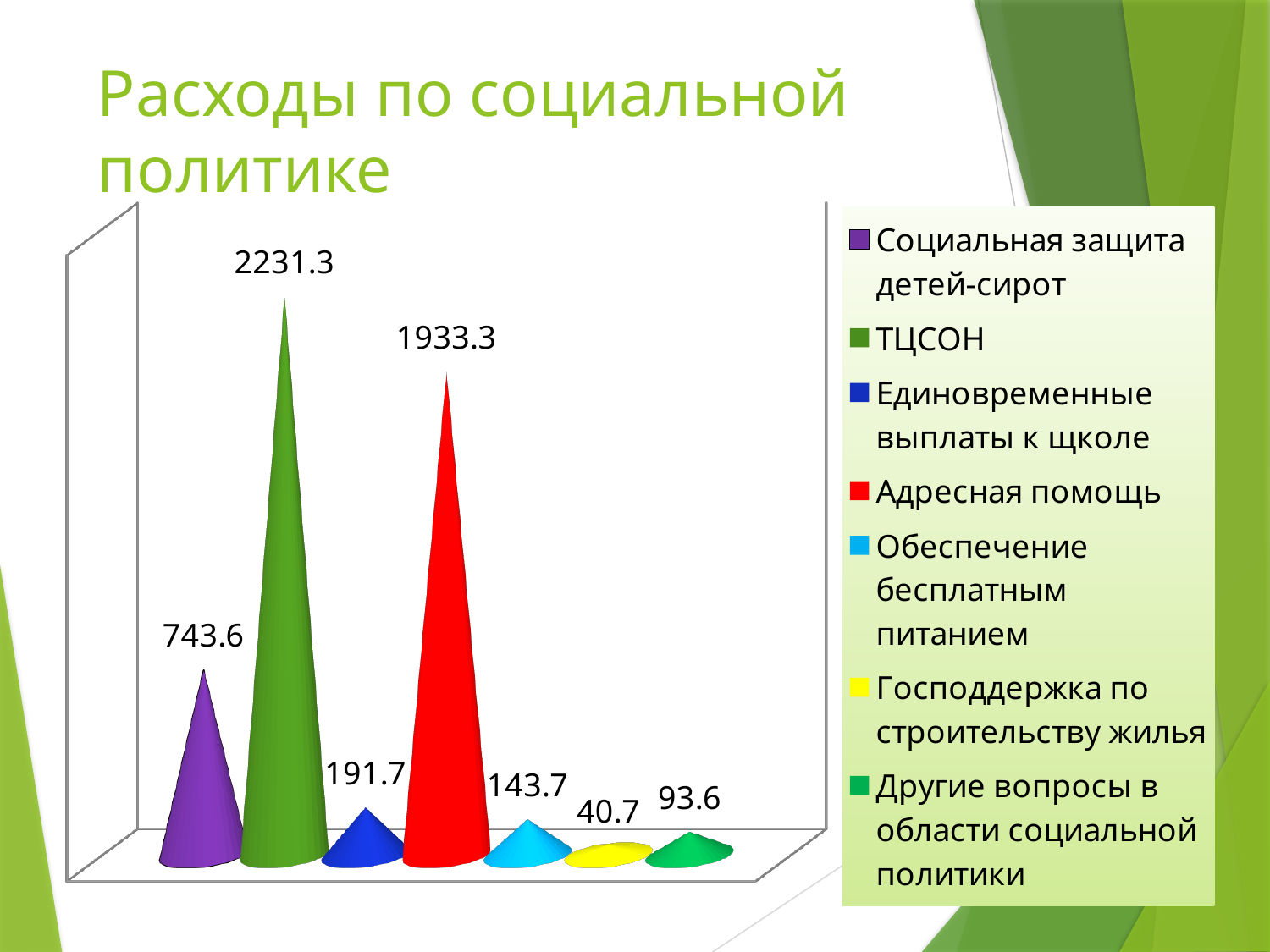
What is the value for ТЦСОН? 2231.3 What is the difference between the values for Социальная защита детей-сирот and Единовременные выплаты к школе? 551.9 What is the value for Социальная защита детей-сирот? 743.6 What is the difference between the values for ТЦСОН and Адресная помощь? 298.0 What is the value for Адресная помощь? 1933.3 What is the value for Другие вопросы в области социальной политики? 93.6 What kind of chart is shown on the slide? Bar chart Which category has the lowest value? Господдержка по строительству жилья Which category has the highest value? ТЦСОН How many categories are shown in the chart? 7 Which is larger: Обеспечение бесплатным питанием or Другие вопросы в области социальной политики? Обеспечение бесплатным питанием What is the value for Господдержка по строительству жилья? 40.7